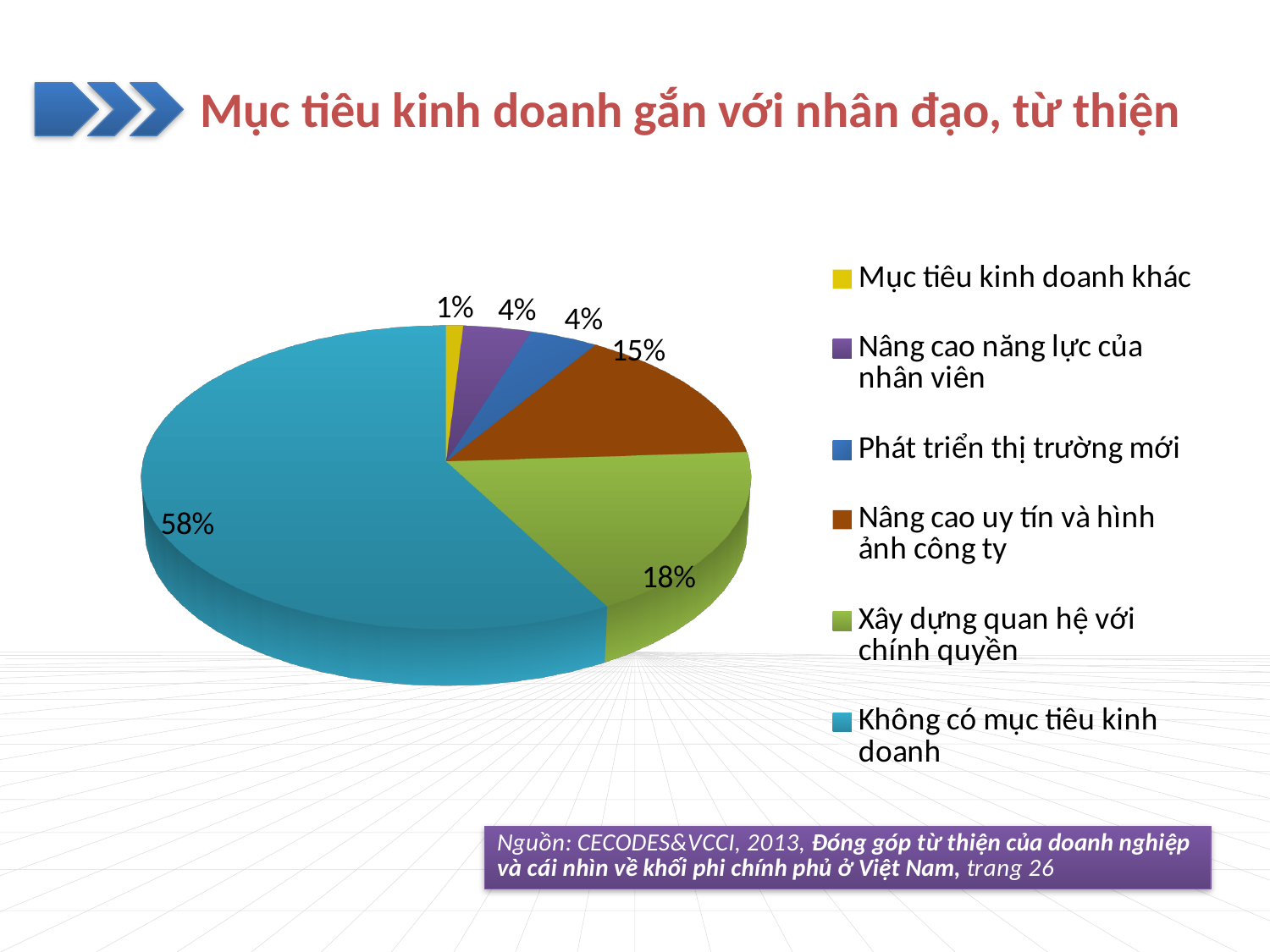
What is the value for "Nâng cao uy tín và hình ảnh công ty"? 15% What is the difference between the values for "Xây dựng quan hệ với chính quyền" and "Nâng cao uy tín và hình ảnh công ty"? 3% How many categories does the legend list? 6 What colour is the slice for "Không có mục tiêu kinh doanh"? Teal (blue-green) Which category has the largest slice of the pie? Không có mục tiêu kinh doanh What is the value for "Mục tiêu kinh doanh khác"? 1% What kind of chart is shown on the slide? Pie chart Which is larger, the value for "Nâng cao uy tín và hình ảnh công ty" or the value for "Nâng cao năng lực của nhân viên"? Nâng cao uy tín và hình ảnh công ty Which category has the smallest slice of the pie? Mục tiêu kinh doanh khác What share of the pie does "Không có mục tiêu kinh doanh" represent? 58% What is the value for "Phát triển thị trường mới"? 4% What is the value for "Xây dựng quan hệ với chính quyền"? 18%